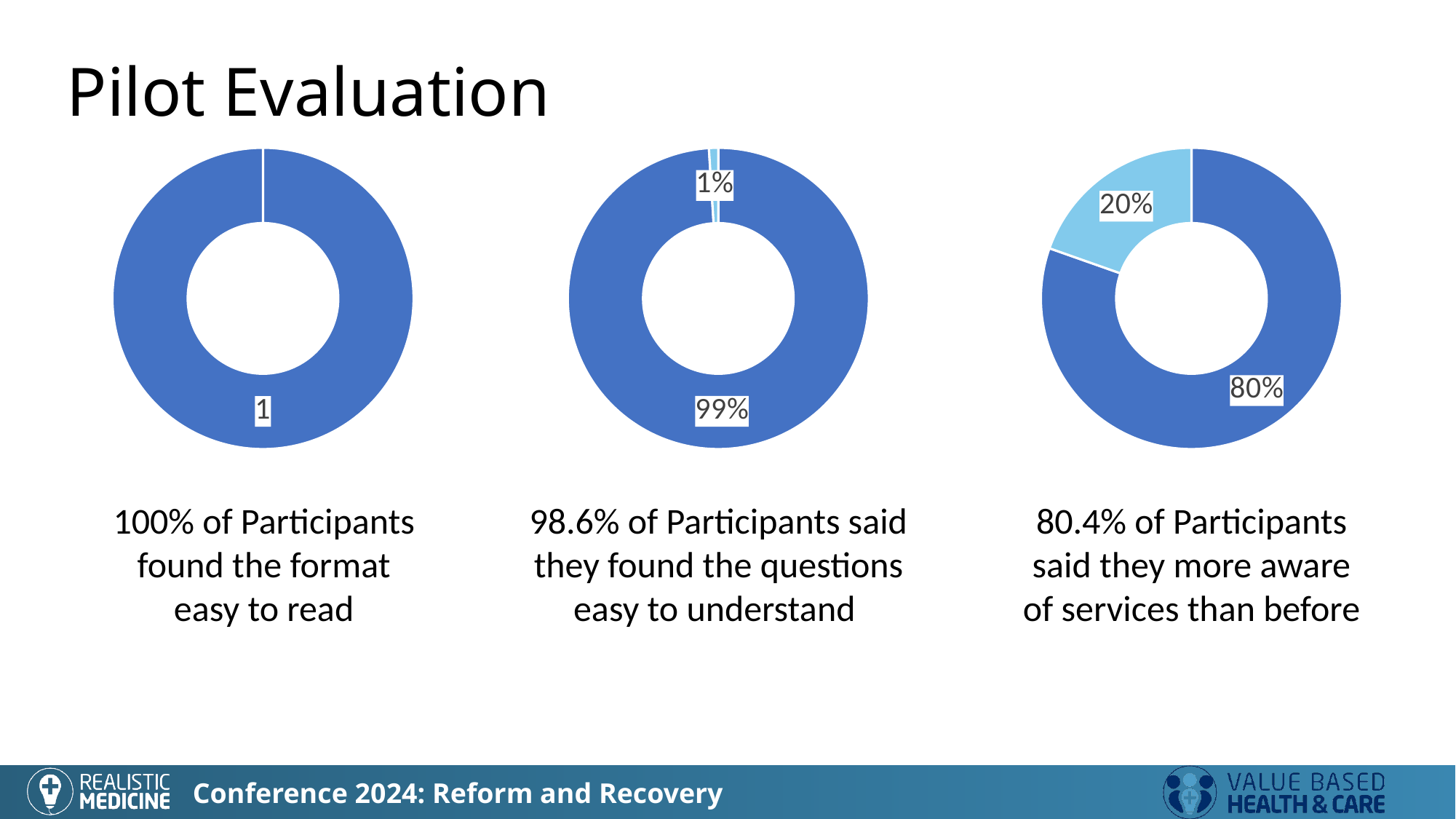
In the right chart, what is the value shown on the light blue segment? 20% What kind of chart is the right chart on the slide? Doughnut chart In the right chart, what is the value shown on the dark blue segment? 80% In the middle chart, what is the value shown on the small light blue segment? 1% How many segments does the right chart have? 2 In the middle chart, what is the difference between the two segment values? 98% How many doughnut charts are shown on the slide? 3 In the right chart, which segment is larger, the dark blue one or the light blue one? Dark blue In the right chart, what is the difference between the two segment values? 60% In the middle chart, what is the value shown on the large dark blue segment? 99% What data label is shown on the left chart? 1 What kind of chart is the left chart on the slide? Doughnut chart